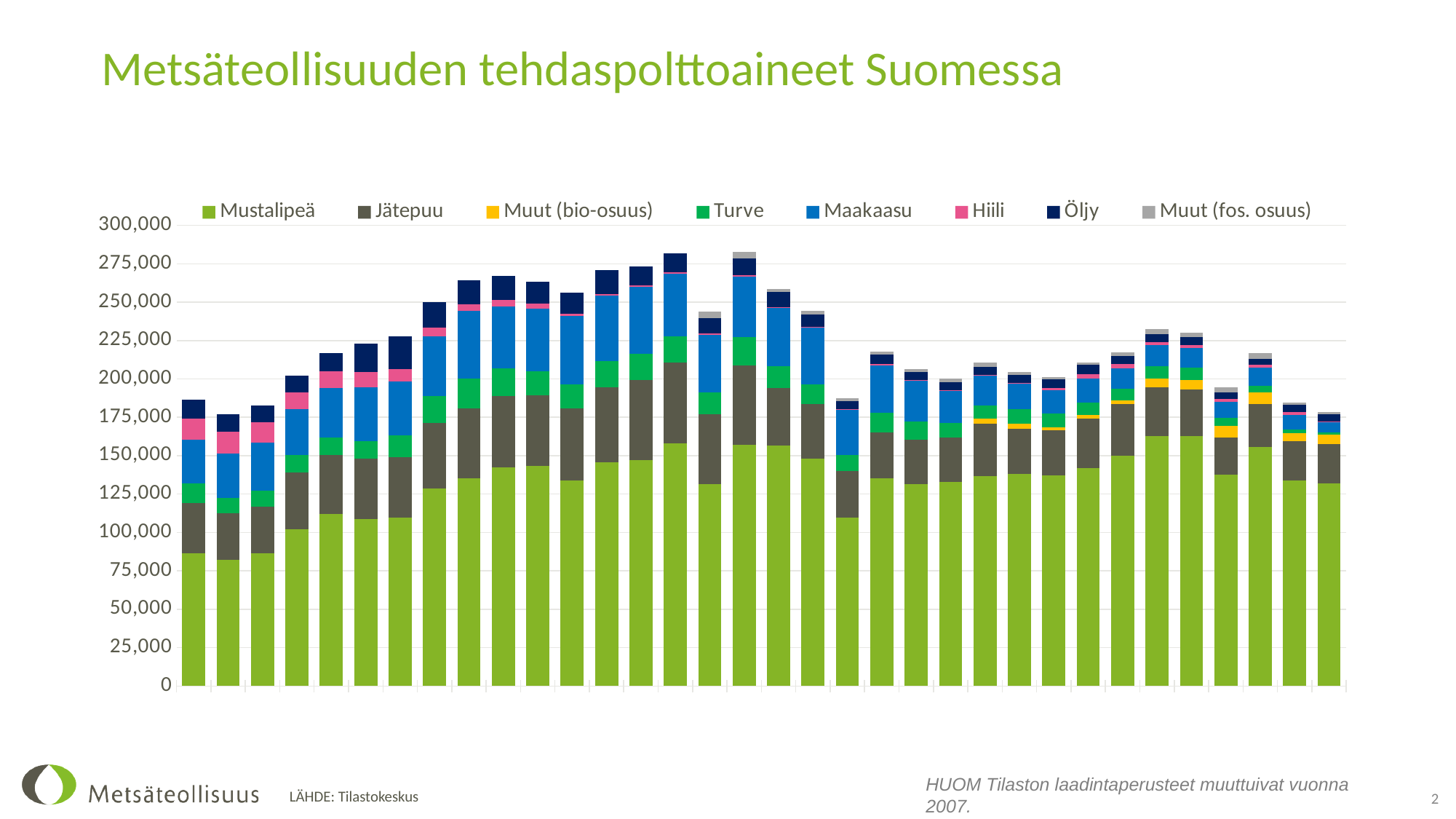
Is the total of the leftmost bar greater or less than 200,000? less Which series is shown in light green at the bottom of each stacked bar? Mustalipeä Is the total of the rightmost bar greater or less than 200,000? less What is the highest value shown on the y axis? 300,000 Is the total of the leftmost bar greater or less than 175,000? greater How many series does the legend list? 8 What is the title of the chart? Metsäteollisuuden tehdaspolttoaineet Suomessa What kind of chart is shown on the slide? Stacked bar chart